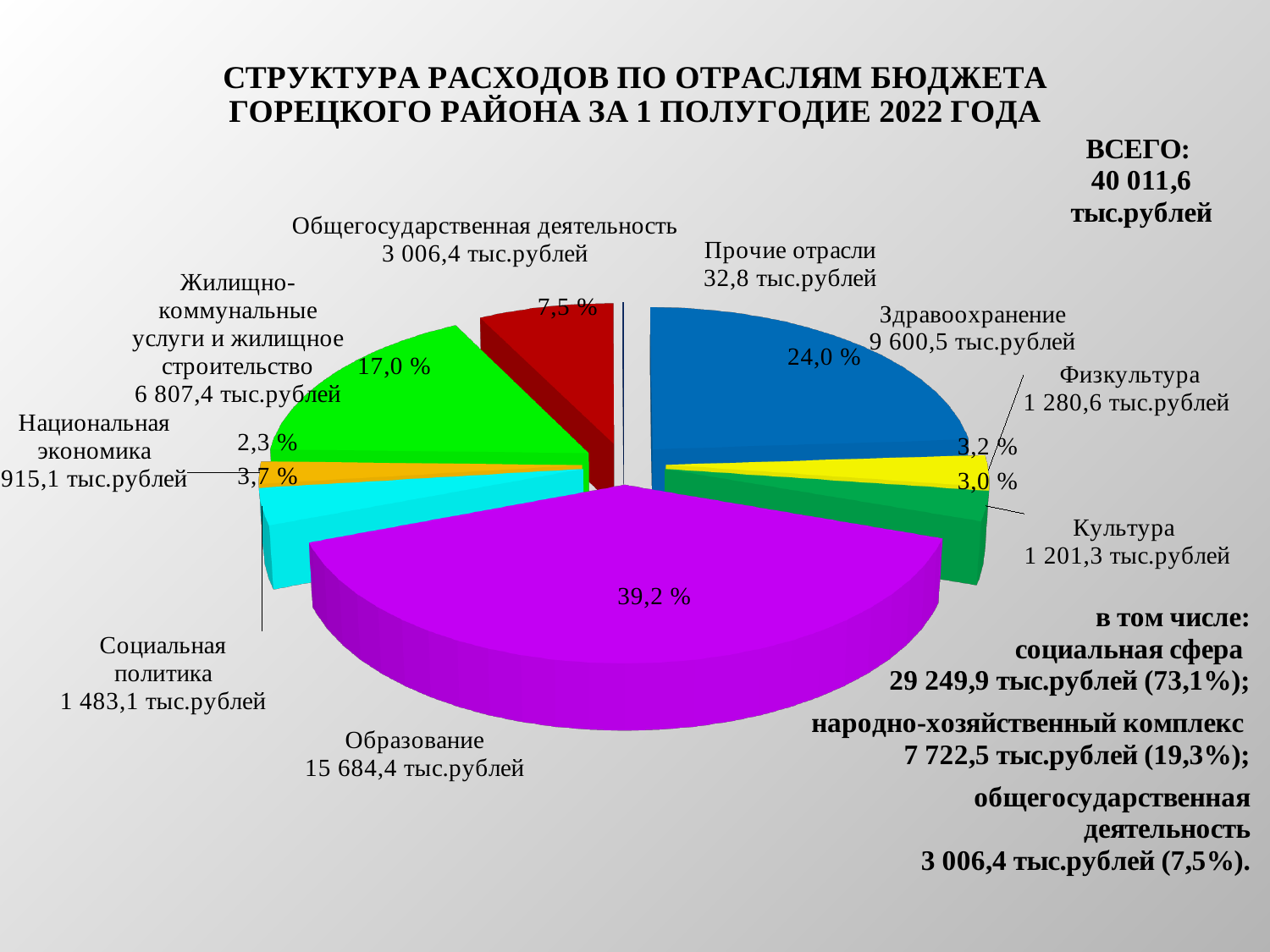
What share of the pie does Жилищно-коммунальные услуги и жилищное строительство take? 17,0 % What kind of chart is shown on the slide? pie chart What is the value for Образование? 15 684,4 тыс.рублей What is the value for Физкультура? 1 280,6 тыс.рублей What is the difference between the values for Образование and Здравоохранение? 6 083,9 тыс.рублей Which category has the largest slice of the pie? Образование Which category has the smallest slice of the pie? Прочие отрасли What share of the pie does Здравоохранение take? 24,0 % What is the value for Прочие отрасли? 32,8 тыс.рублей How many categories are shown in the pie chart? 9 What is the value for Здравоохранение? 9 600,5 тыс.рублей Which is larger, the value for Социальная политика or the value for Культура? Социальная политика